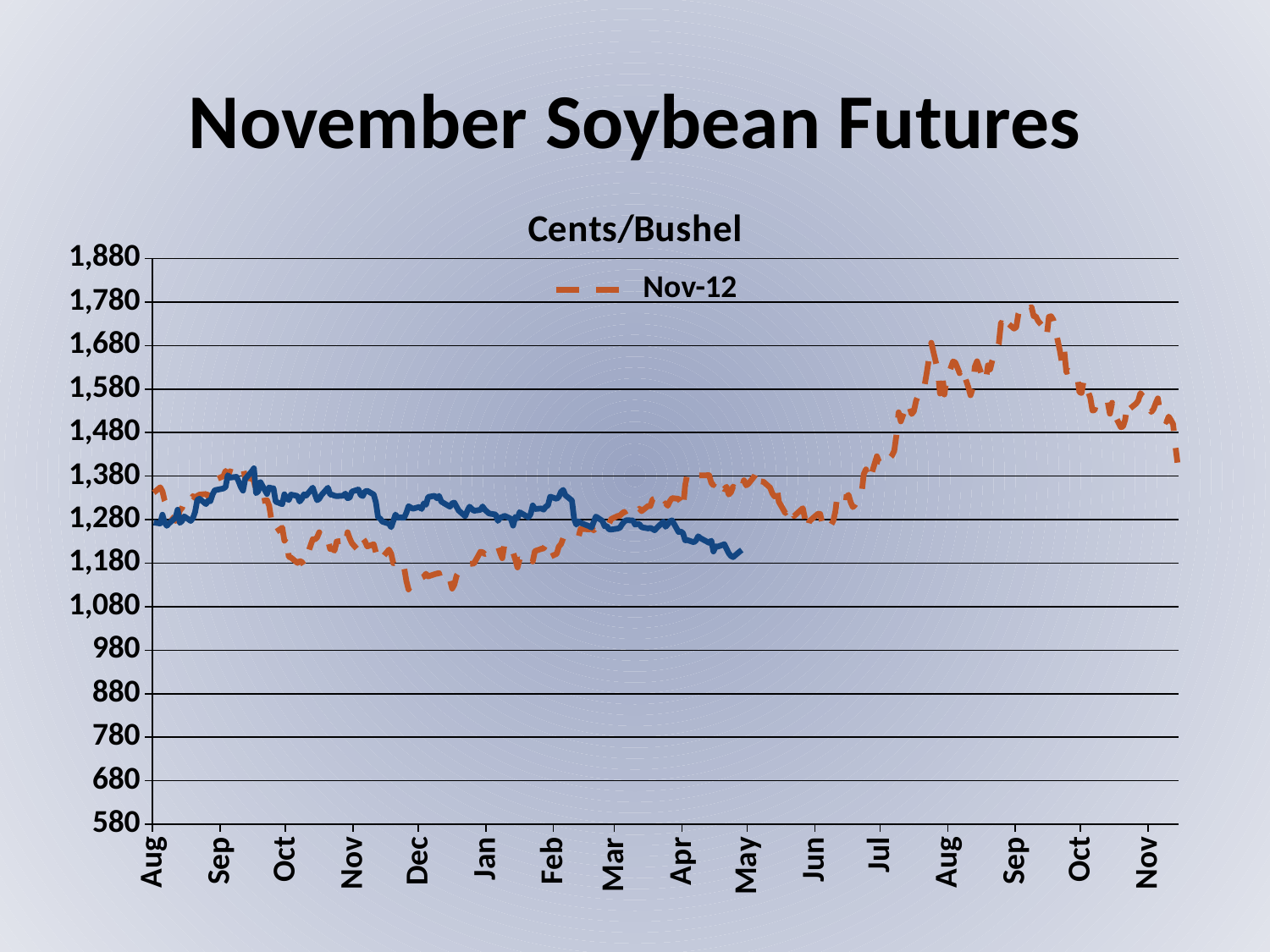
Around which month does the Nov-12 series reach its highest value? Sep Which series does the chart legend list? Nov-12 Is the value of the Nov-12 series around Dec greater or less than 1,180? less What kind of chart is shown on the slide? line chart How many month labels are shown along the x axis? 16 Is the final value of the solid blue line, around May, greater or less than 1,280? less Is the peak value of the Nov-12 series, reached around the second Sep, greater or less than 1,680? greater How many series does the legend list? 1 What is the title of the chart? Cents/Bushel Does the Nov-12 series rise or fall between Jun and the second Sep? rise